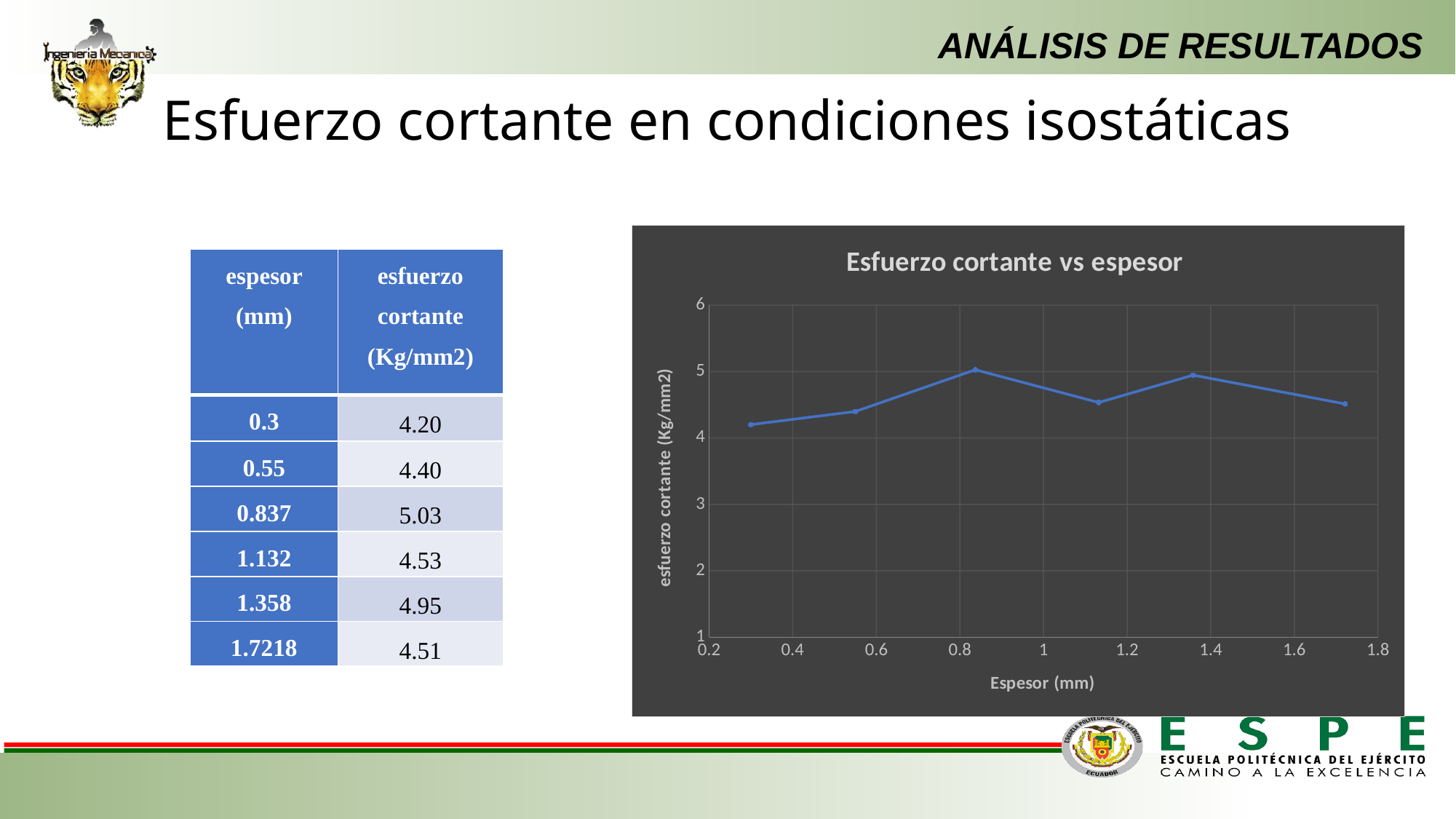
What is the esfuerzo cortante value at an espesor of 0.3 mm? 4.20 What is the title of the chart? Esfuerzo cortante vs espesor What is the label of the x axis of the chart? Espesor (mm) Is the esfuerzo cortante at an espesor of 1.132 mm greater or less than 5? less What is the difference between the esfuerzo cortante at 0.837 mm and at 0.3 mm? 0.83 What is the esfuerzo cortante value at an espesor of 1.7218 mm? 4.51 How many data points are plotted on the line in the chart? 6 What is the esfuerzo cortante value at an espesor of 0.837 mm? 5.03 At which espesor is the esfuerzo cortante highest? 0.837 What kind of chart is shown on the slide? line chart Does the esfuerzo cortante rise or fall as espesor increases from 0.3 mm to 0.837 mm? rise At which espesor is the esfuerzo cortante lowest? 0.3